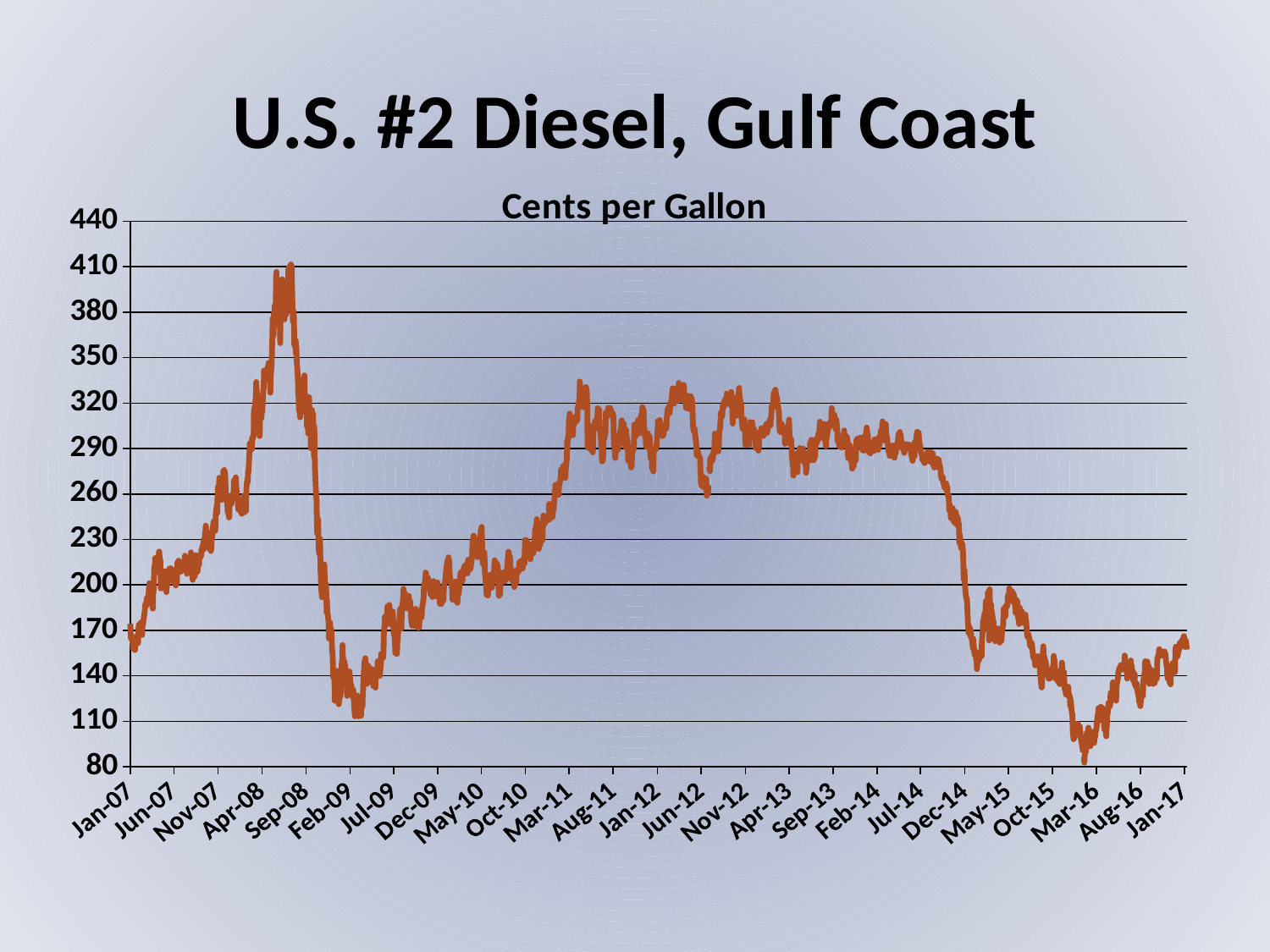
Which is higher, the value around Feb-09 or the value around Jul-14? Jul-14 Around which x-axis label does the diesel price reach its highest point? Sep-08 Is the value at Jan-17 greater or less than 200? less What is the title of the chart? Cents per Gallon Around which x-axis label does the diesel price reach its lowest point? Mar-16 What unit is the chart's vertical axis measured in, according to the subtitle? Cents per Gallon Is the value around Feb-09 greater or less than 200? less Is the lowest value around Mar-16 greater or less than 140? less What kind of chart is shown on the slide? Line chart Do the values rise or fall between Jul-14 and Dec-14? fall